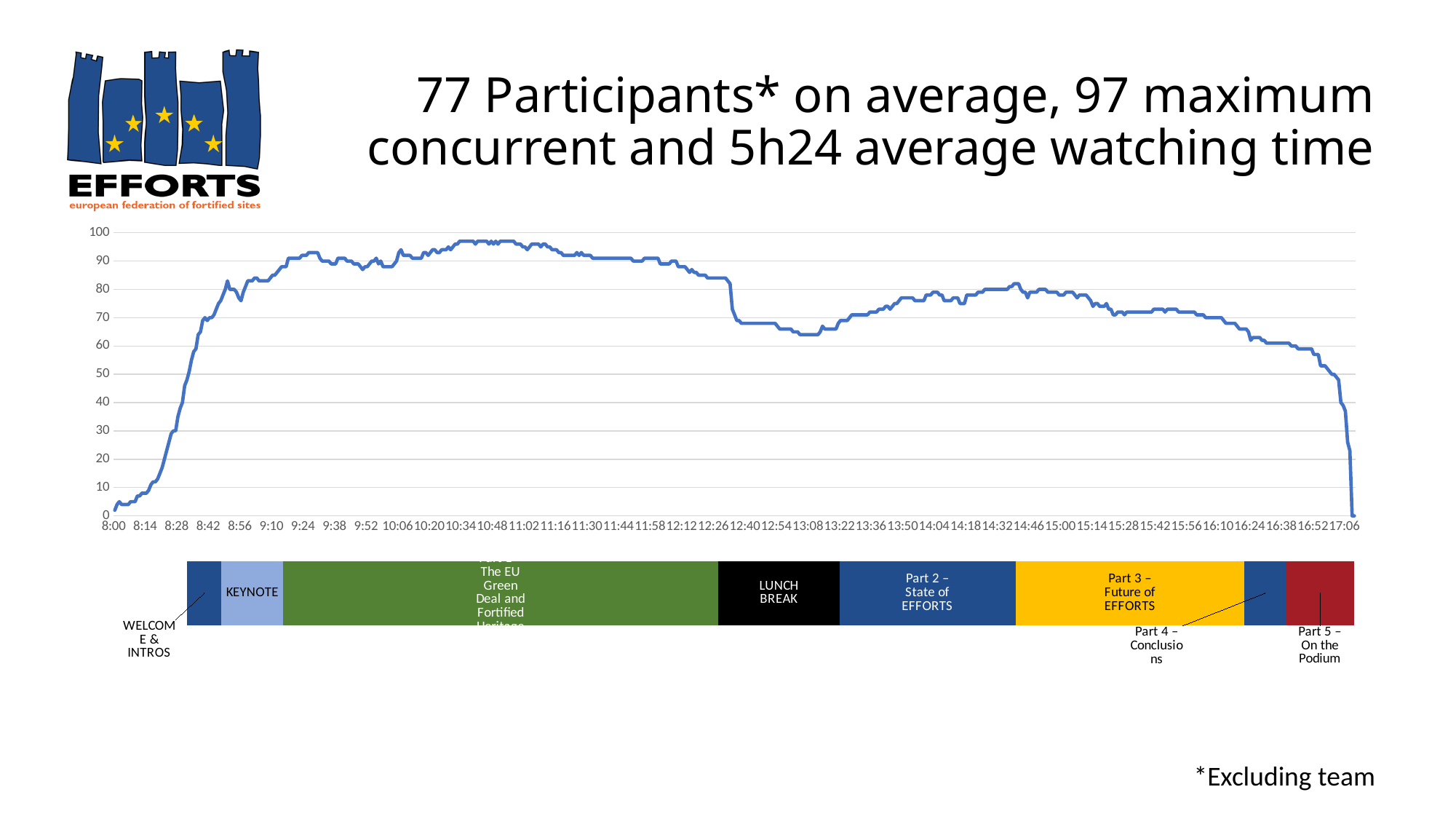
Is the value at 13:08 greater or less than 70? less What kind of chart is shown on the slide? line chart According to the slide title, what was the average number of participants? 77 Does the line rise or fall between 16:24 and 17:06? fall Is the value at 10:34 greater or less than 90? greater Is the value at 14:32 greater or less than 70? greater What is the highest value shown on the vertical axis? 100 According to the slide title, what was the maximum number of concurrent participants? 97 Does the line rise or fall between 8:00 and 8:42? rise